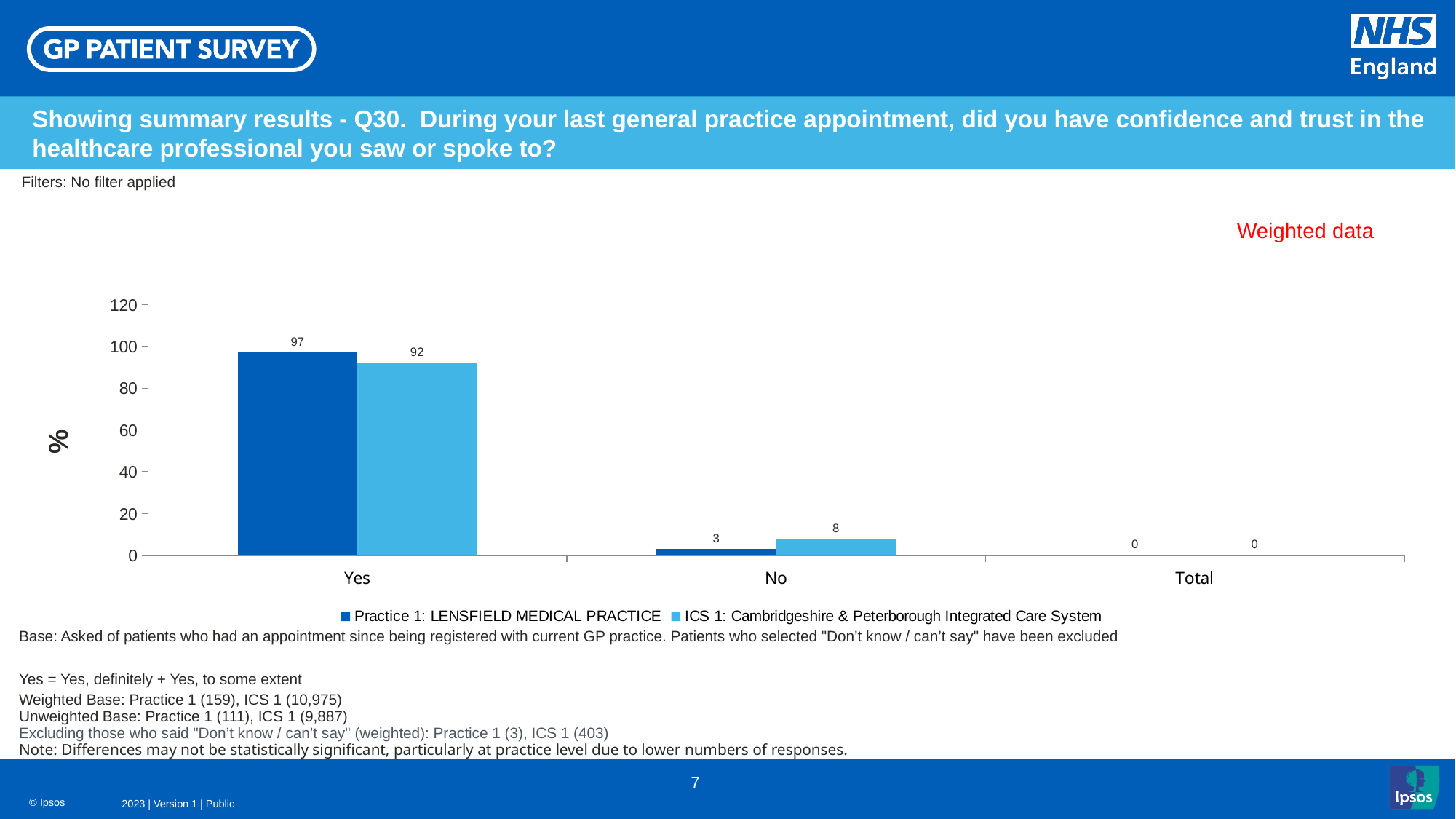
What is the value for Practice 1: LENSFIELD MEDICAL PRACTICE in the Yes category? 97 How many categories are shown on the x axis of the chart? 3 What is the difference between the ICS 1 and Practice 1 values in the No category? 5 How many series does the chart legend list? 2 What is the value for ICS 1: Cambridgeshire & Peterborough Integrated Care System in the No category? 8 What kind of chart is shown on the slide? Bar chart What is the value shown for the Total category for Practice 1: LENSFIELD MEDICAL PRACTICE? 0 What is the difference between the Practice 1 and ICS 1 values in the Yes category? 5 Which category has the highest value for Practice 1: LENSFIELD MEDICAL PRACTICE? Yes What is the value for Practice 1: LENSFIELD MEDICAL PRACTICE in the No category? 3 In the No category, which series has the larger value, Practice 1: LENSFIELD MEDICAL PRACTICE or ICS 1: Cambridgeshire & Peterborough Integrated Care System? ICS 1: Cambridgeshire & Peterborough Integrated Care System What is the value for ICS 1: Cambridgeshire & Peterborough Integrated Care System in the Yes category? 92